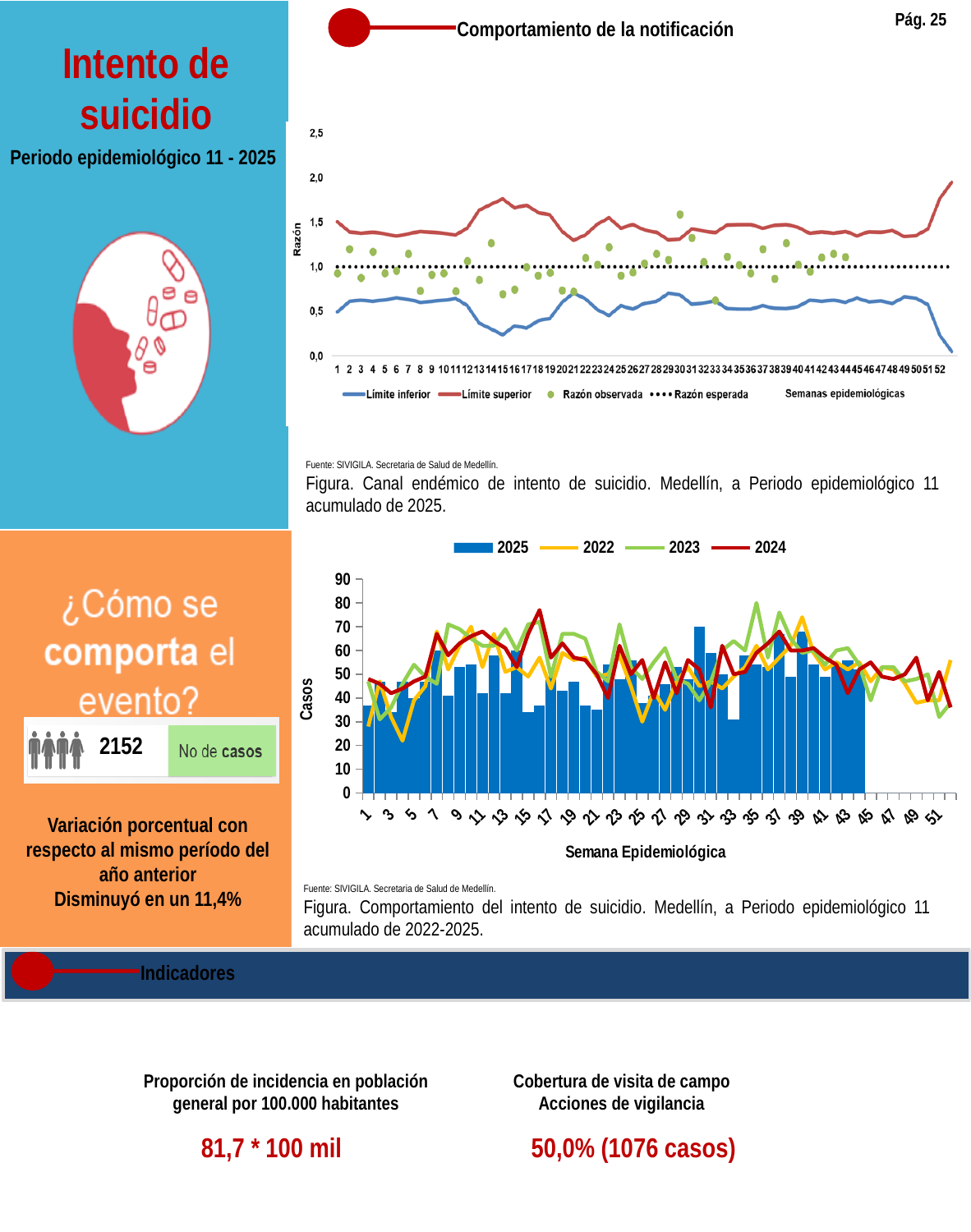
In the top chart (Canal endémico), is the 'Límite superior' value at week 52 greater or less than 1,5? greater In the top chart (Canal endémico), is the 'Límite inferior' value at week 52 greater or less than 0,5? less In the top chart (Canal endémico), which series is drawn as green dots? Razón observada In the top chart (Canal endémico), at what value does the dotted 'Razón esperada' line sit? 1,0 In the top chart (Canal endémico), what is the label of the vertical axis? Razón In the bottom chart (Comportamiento del intento de suicidio), is the 2025 value at week 32 greater or less than 40? greater In the bottom chart (Comportamiento del intento de suicidio), how many series does the legend list? 4 In the bottom chart (Comportamiento del intento de suicidio), what is the label of the horizontal axis? Semana Epidemiológica In the top chart (Canal endémico), how many series does the legend list? 4 In the bottom chart (Comportamiento del intento de suicidio), which year is plotted as bars rather than a line? 2025